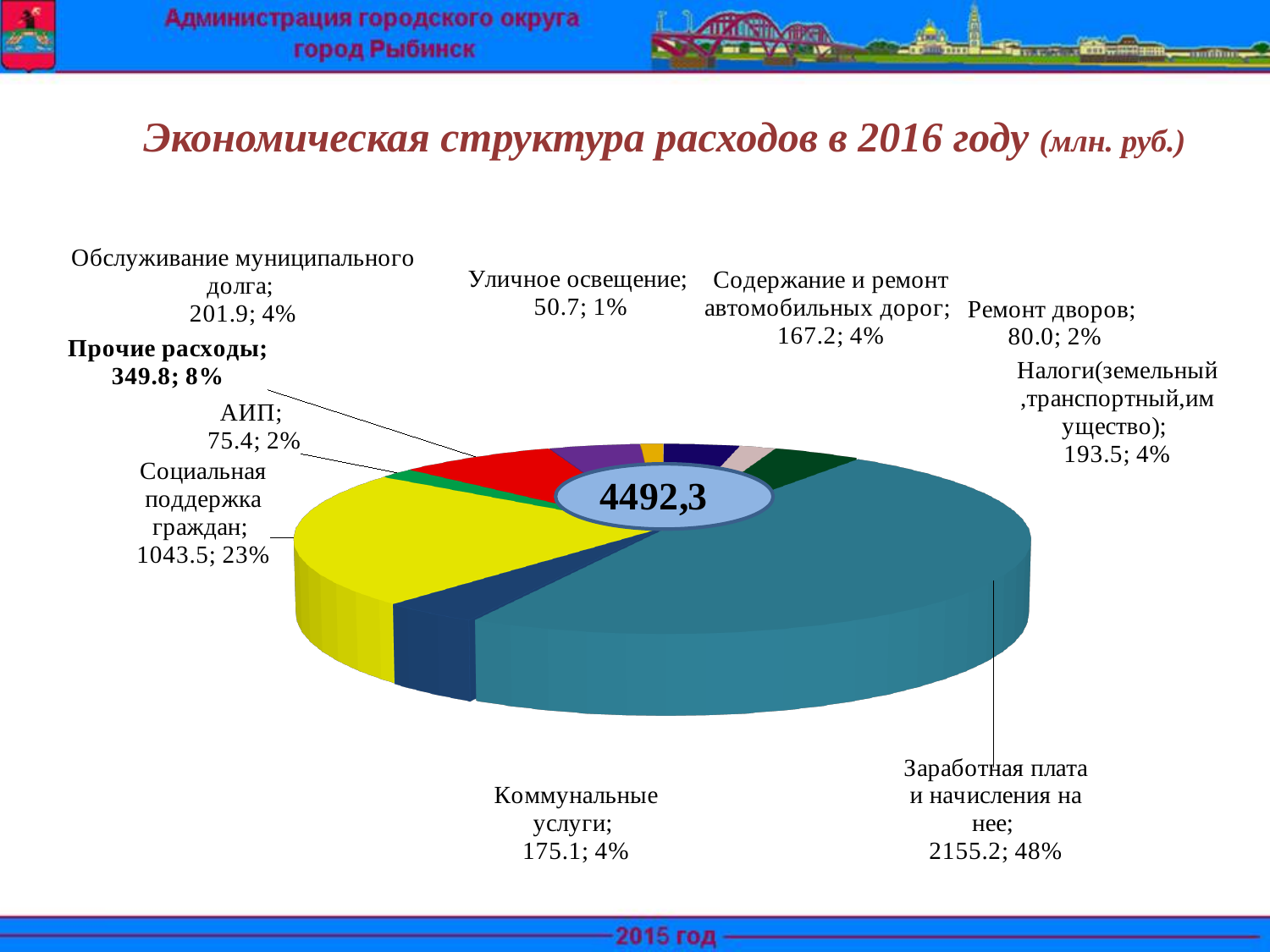
What share of the pie does "Социальная поддержка граждан" represent? 23% What is the value for "Заработная плата и начисления на нее"? 2155.2 Which category has the largest slice of the pie? Заработная плата и начисления на нее What total value is printed in the centre of the pie chart? 4492,3 What is the value for "Уличное освещение"? 50.7 How many categories are shown in the pie chart? 10 What share of the pie does "Ремонт дворов" represent? 2% Which category has the smallest slice of the pie? Уличное освещение What kind of chart is shown on the slide? pie chart Which is larger: the value for "Коммунальные услуги" or the value for "Содержание и ремонт автомобильных дорог"? Коммунальные услуги What is the difference between the values for "Прочие расходы" and "Обслуживание муниципального долга"? 147.9 What is the title of the chart on the slide? Экономическая структура расходов в 2016 году (млн. руб.)